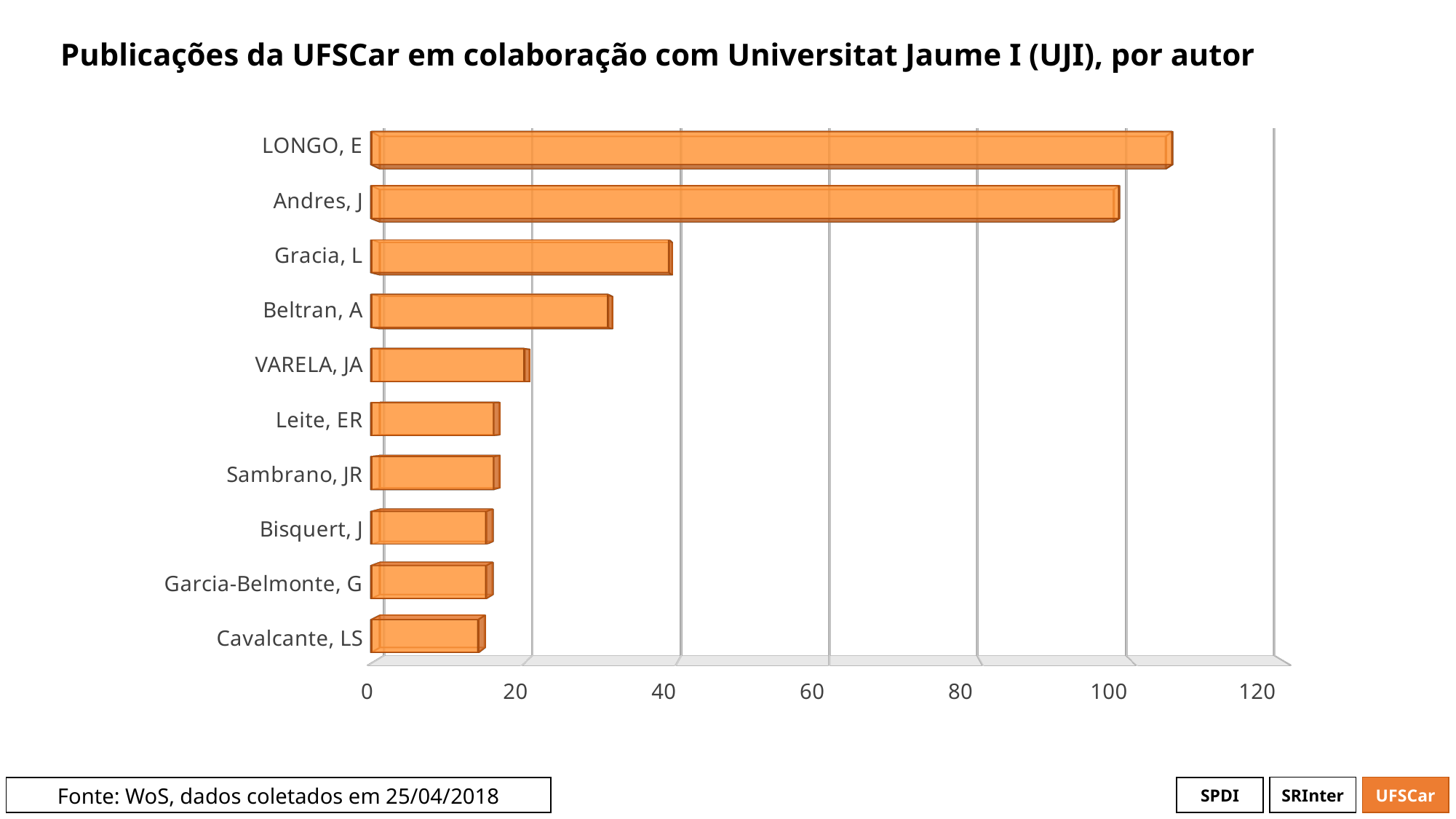
What kind of chart is shown on the slide? bar chart Is the value for Beltran, A greater or less than 40? less What is the title of the chart? Publicações da UFSCar em colaboração com Universitat Jaume I (UJI), por autor Is the value for Beltran, A greater or less than 20? greater Is the value for Leite, ER greater or less than 20? less Do the bar values increase or decrease going from the top author to the bottom author? decrease Which author has the lowest number of publications? Cavalcante, LS How many authors are listed on the chart? 10 Which author has the highest number of publications? LONGO, E Which has more publications, Gracia, L or Beltran, A? Gracia, L